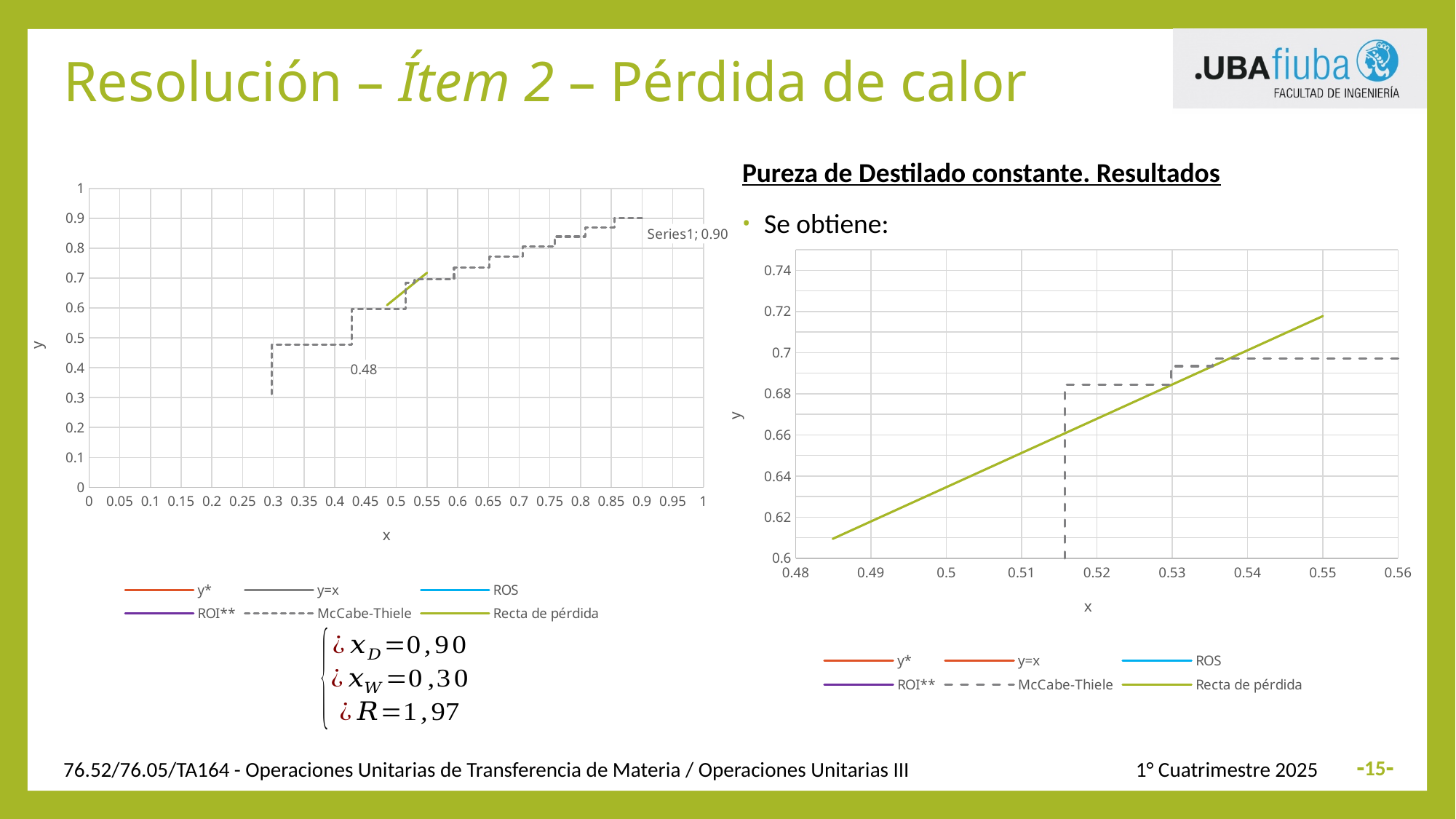
In the right chart, does the Recta de pérdida line rise or fall as x increases? rise How many series does the legend of the left chart list? 6 In the left chart, what value is printed in the data label near the step at x = 0.3 to 0.4? 0.48 In the left chart, is the top of the McCabe-Thiele staircase (labelled Series1) greater or less than 0.8? greater Which series in the legend of the right chart is drawn with a dashed line? McCabe-Thiele What is the range of the x axis in the right chart? 0.48 to 0.56 What kind of chart is the chart on the left of the slide? line chart In the right chart, is the value of the Recta de pérdida line at x = 0.55 greater or less than 0.7? greater In the left chart, does the McCabe-Thiele staircase rise or fall as x increases? rise In the left chart, what value is shown in the data label at the top right of the McCabe-Thiele staircase? 0.90 In the right chart, is the value of the Recta de pérdida line at its left end (near x = 0.485) greater or less than 0.62? less How many series does the legend of the right chart list? 6